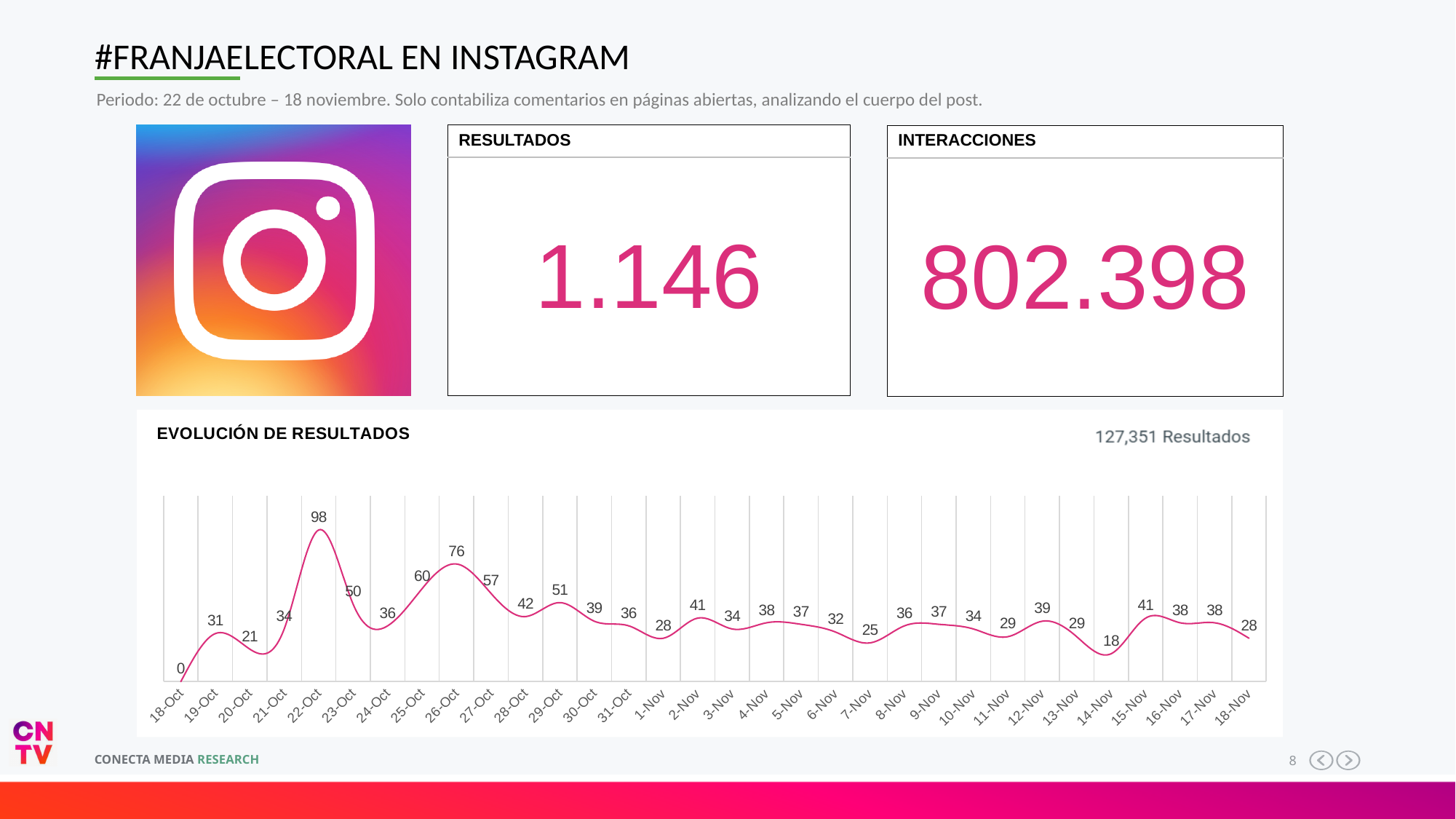
In the EVOLUCIÓN DE RESULTADOS chart, do the values rise or fall from 22-Oct to 24-Oct? fall In the EVOLUCIÓN DE RESULTADOS chart, which date has the highest value? 22-Oct In the EVOLUCIÓN DE RESULTADOS chart, what is the value for 26-Oct? 76 What is the title of the line chart on the slide? EVOLUCIÓN DE RESULTADOS What type of chart is shown under EVOLUCIÓN DE RESULTADOS? line chart In the EVOLUCIÓN DE RESULTADOS chart, which is larger, the value for 29-Oct or the value for 2-Nov? 29-Oct In the EVOLUCIÓN DE RESULTADOS chart, which date has the lowest value? 18-Oct In the EVOLUCIÓN DE RESULTADOS chart, what is the difference between the values for 22-Oct and 23-Oct? 48 How many dates are plotted in the EVOLUCIÓN DE RESULTADOS chart? 32 In the EVOLUCIÓN DE RESULTADOS chart, what is the value for 18-Nov? 28 In the EVOLUCIÓN DE RESULTADOS chart, what is the value for 14-Nov? 18 In the EVOLUCIÓN DE RESULTADOS chart, what is the value for 22-Oct? 98